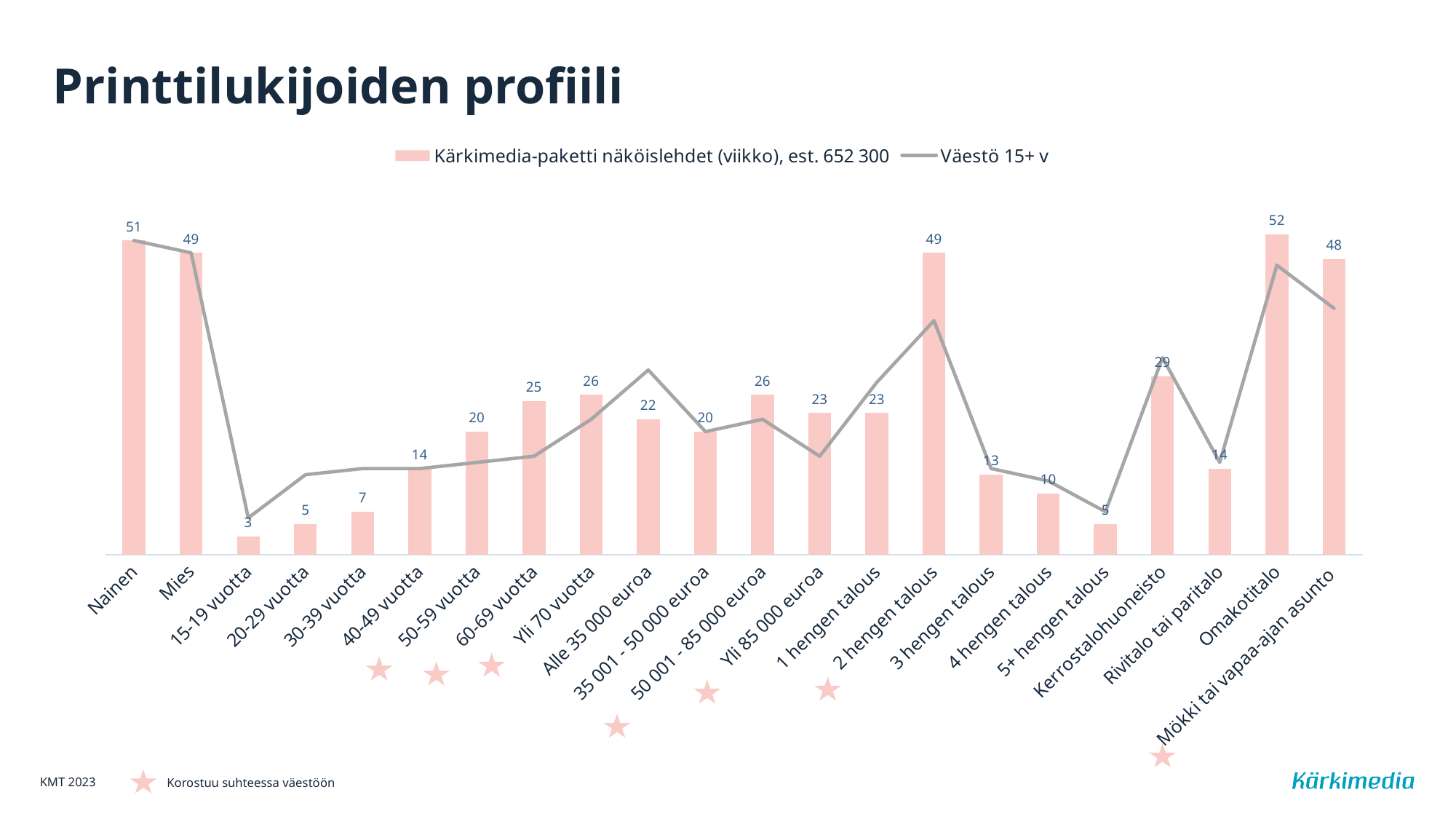
Which has a larger bar value, 3 hengen talous or 4 hengen talous? 3 hengen talous What is the difference between the bar values for Yli 70 vuotta and 15-19 vuotta? 23 How many categories are shown on the x axis? 22 Which series is drawn as a grey line? Väestö 15+ v Which category has the lowest bar value? 15-19 vuotta How many series does the legend list? 2 What is the value of the bar for Kerrostalohuoneisto? 29 Do the bar values rise or fall across the age groups from 15-19 vuotta to Yli 70 vuotta? rise Which category has the highest bar value? Omakotitalo What is the difference between the bar values for Omakotitalo and Mökki tai vapaa-ajan asunto? 4 What is the value of the Kärkimedia-paketti näköislehdet bar for Nainen? 51 What is the value of the bar for 2 hengen talous? 49